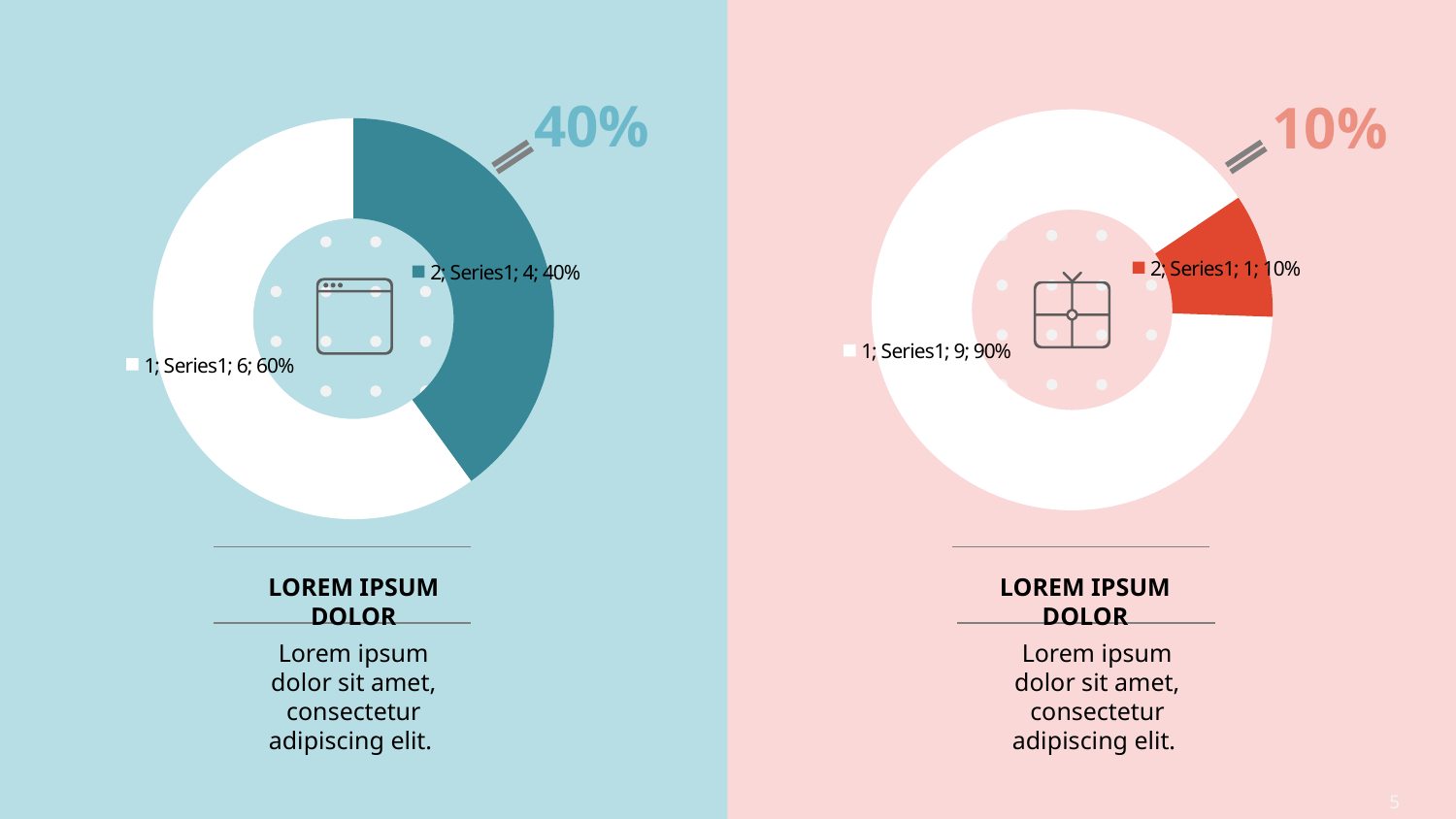
On the right chart, which category has the largest slice? 1 On the left chart, what percentage share does category 2 have? 40% On the right chart, what is the total of the two category values? 10 How many categories does the right chart have? 2 On the right chart, what percentage share does category 2 have? 10% On the right chart, what is the difference between the values for category 1 and category 2? 8 On the left chart, which category has the smallest slice? 2 On the left chart, what is the difference between the values for category 1 and category 2? 2 On the left chart, what percentage share does category 1 have? 60% On the left chart, what is the value for category 2? 4 What kind of chart is shown on the left side of the slide? Doughnut chart On the right chart, what is the value for category 1? 9